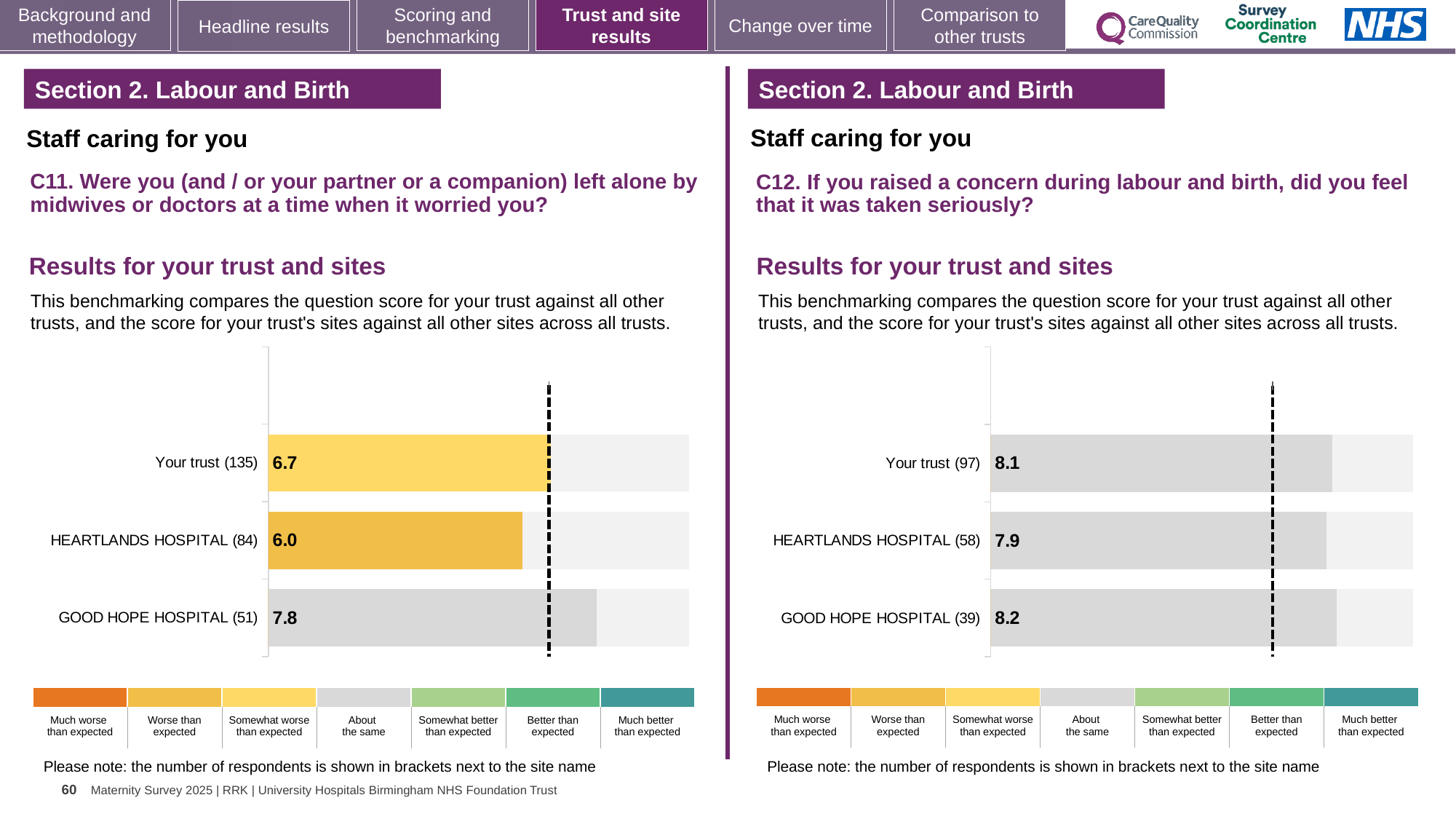
How many bars are plotted in the C12 chart on the right? 3 In the C12 chart on the right, what is the score for Your trust (97)? 8.1 In the C11 chart on the left, what is the difference between the scores for GOOD HOPE HOSPITAL (51) and HEARTLANDS HOSPITAL (84)? 1.8 In the C11 chart on the left, what is the score for GOOD HOPE HOSPITAL (51)? 7.8 In the C12 chart on the right, what is the score for GOOD HOPE HOSPITAL (39)? 8.2 In the C11 chart on the left, what is the score for HEARTLANDS HOSPITAL (84)? 6.0 In the C11 chart on the left, which site or trust has the lowest score? HEARTLANDS HOSPITAL (84) What kind of chart is used in the C11 chart on the left? Bar chart In the C11 chart on the left, which site or trust has the highest score? GOOD HOPE HOSPITAL (51) In the C11 chart on the left, what is the score for Your trust (135)? 6.7 In the C12 chart on the right, what is the score for HEARTLANDS HOSPITAL (58)? 7.9 In the C12 chart on the right, what is the difference between the scores for GOOD HOPE HOSPITAL (39) and HEARTLANDS HOSPITAL (58)? 0.3